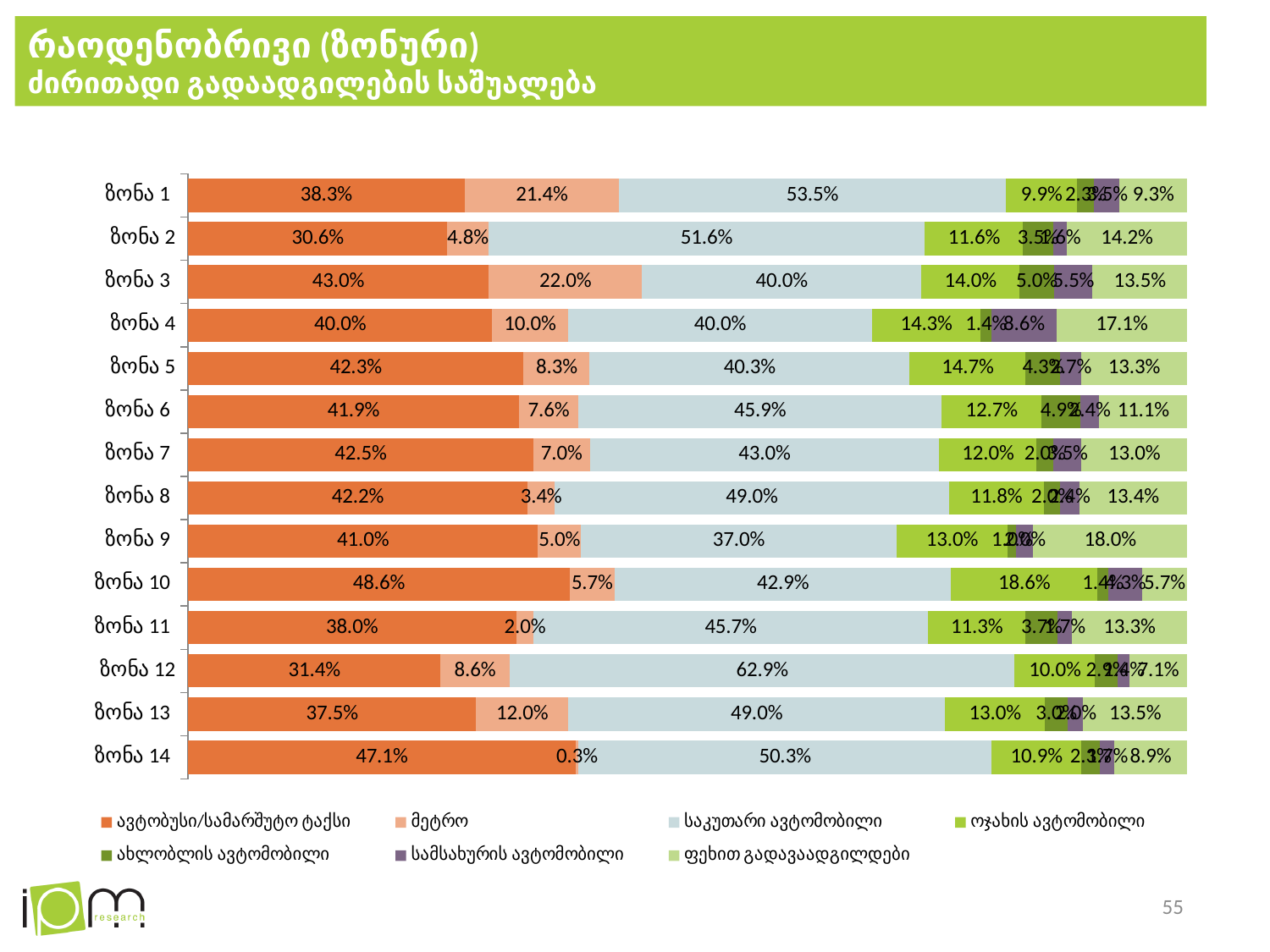
What kind of chart is shown on the slide? Stacked bar chart What is the value of the ოჯახის ავტომობილი segment for ზონა 10? 18.6% What is the difference between the ავტობუსი/სამარშუტო ტაქსი share of ზონა 10 and that of ზონა 2? 18.0 percentage points How many series does the legend list? 7 Which zone has the lowest ავტობუსი/სამარშუტო ტაქსი share? ზონა 2 What is the value of the მეტრო segment for ზონა 14? 0.3% Which zone has the highest ავტობუსი/სამარშუტო ტაქსი share? ზონა 10 What is the value of the საკუთარი ავტომობილი segment for ზონა 12? 62.9% Which zone has the highest საკუთარი ავტომობილი share? ზონა 12 What is the value of the ავტობუსი/სამარშუტო ტაქსი segment for ზონა 1? 38.3% Which has a larger მეტრო share, ზონა 3 or ზონა 1? ზონა 3 How many zones are shown in the chart? 14